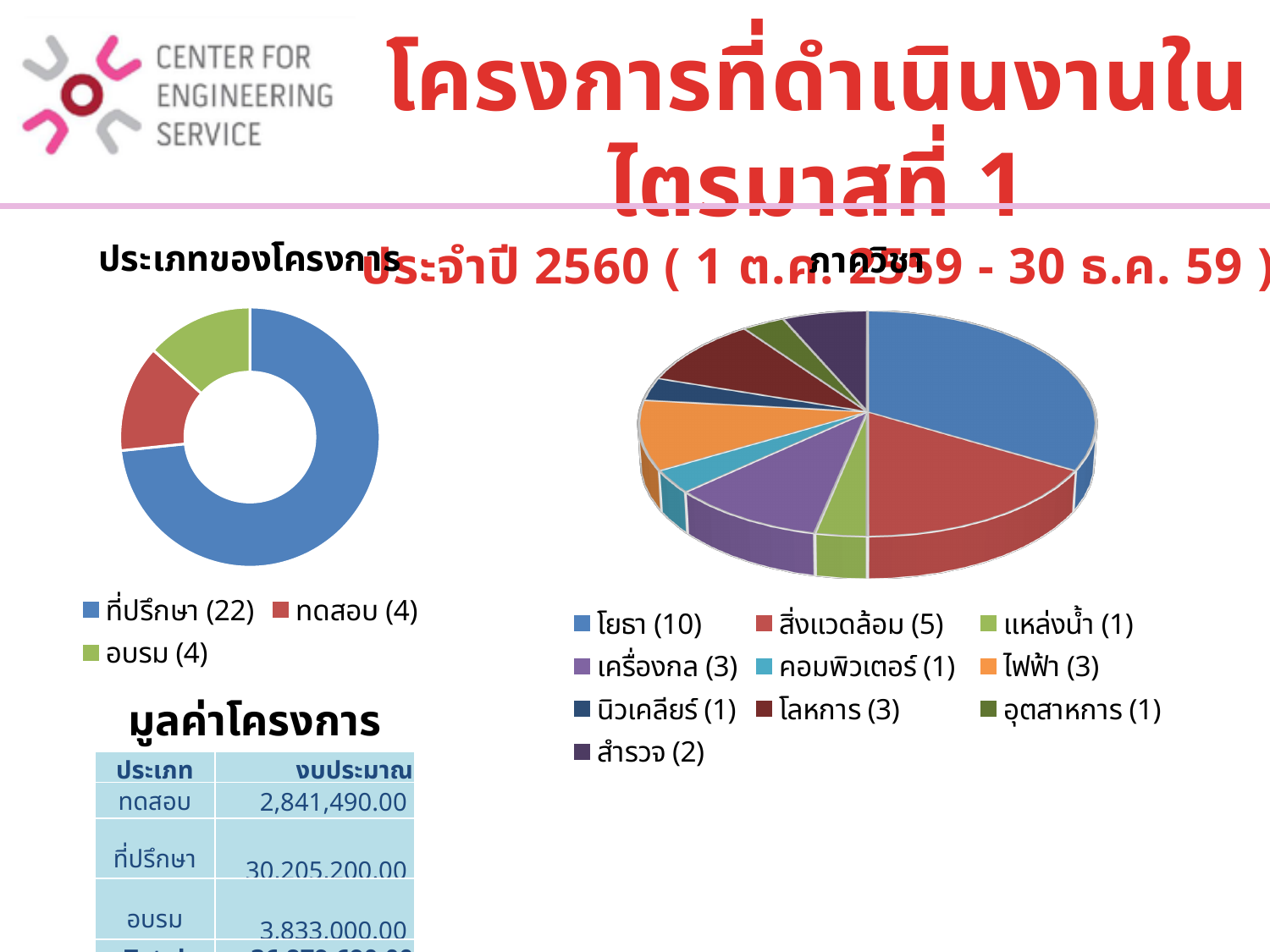
In the ประเภทของโครงการ chart, what is the total number of projects across all categories? 30 In the ประเภทของโครงการ chart, which category has the highest number of projects? ที่ปรึกษา In the ประเภทของโครงการ chart, what is the difference between ที่ปรึกษา and ทดสอบ? 18 How many categories does the ประเภทของโครงการ chart show? 3 In the ประเภทของโครงการ chart, how many projects are in the ที่ปรึกษา category? 22 What kind of chart is the ประเภทของโครงการ chart? Doughnut chart What kind of chart is the ภาควิชา chart? Pie chart In the ภาควิชา chart, how many projects are in สิ่งแวดล้อม? 5 How many departments does the ภาควิชา chart show? 10 In the ภาควิชา chart, which has more projects, เครื่องกล or สำรวจ? เครื่องกล In the ภาควิชา chart, what is the difference between โยธา and สิ่งแวดล้อม? 5 In the ภาควิชา chart, which department has the highest number of projects? โยธา